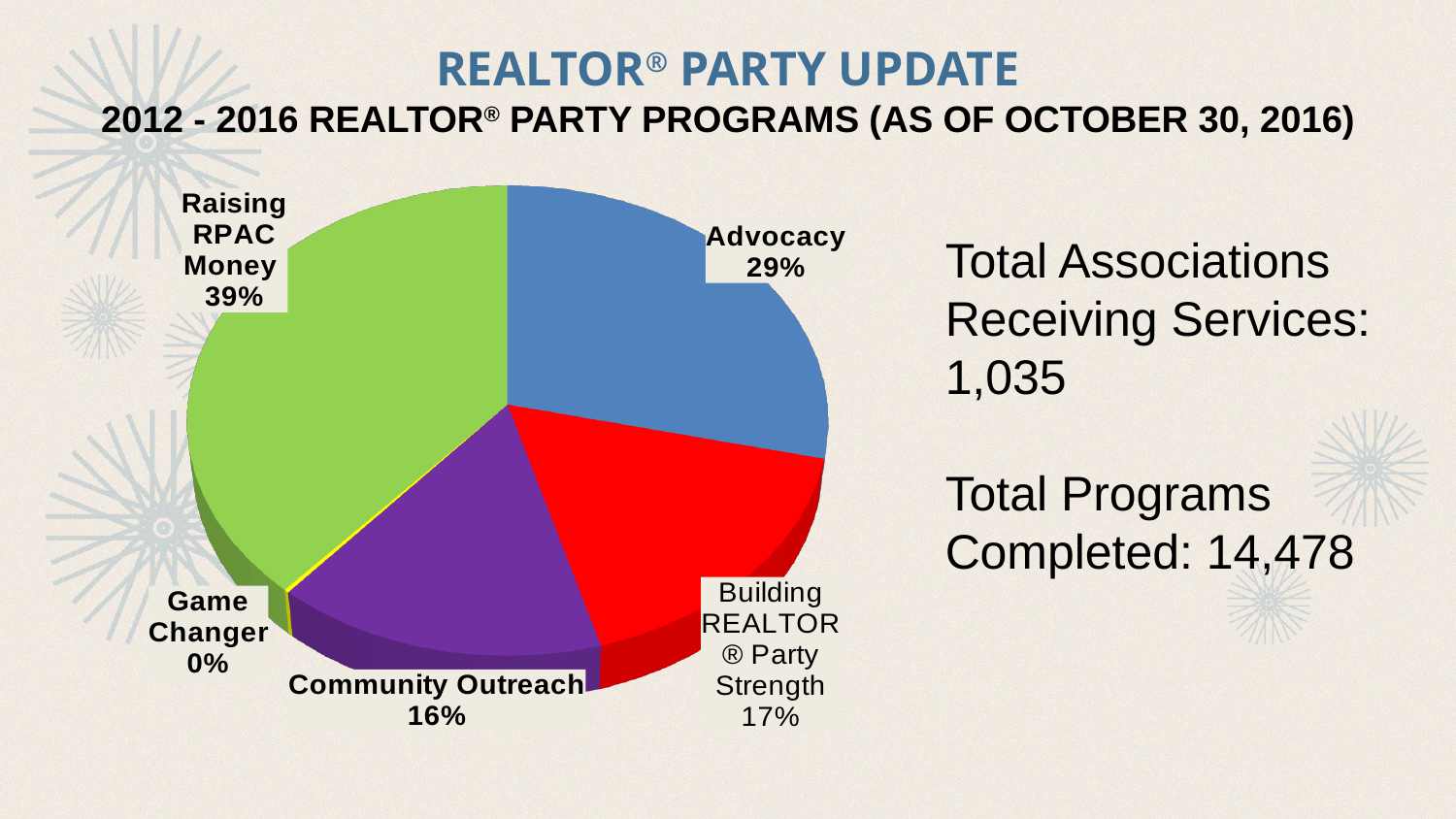
What is the difference in percentage points between Raising RPAC Money and Advocacy? 10 What kind of chart is shown on the slide? pie chart What share of the pie does Advocacy represent? 29% How many categories are shown in the pie chart? 5 What share of the pie does Raising RPAC Money represent? 39% What share of the pie does Community Outreach represent? 16% Which category has the largest share of the pie? Raising RPAC Money Which is larger, the share for Advocacy or the share for Community Outreach? Advocacy What colour is the Raising RPAC Money slice? green Which category has the smallest share of the pie? Game Changer